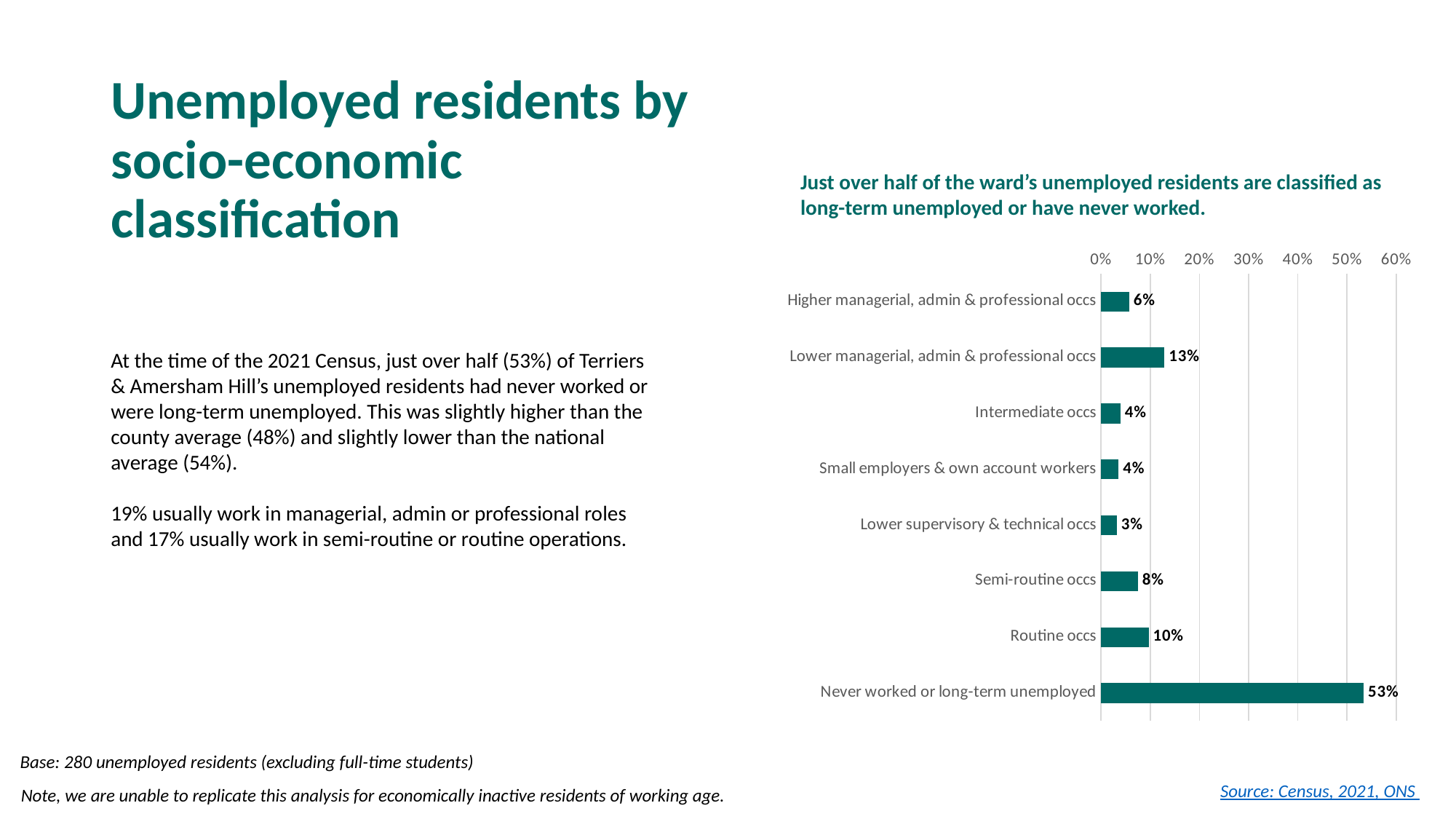
What is the value for 'Lower supervisory & technical occs'? 3% What is the source cited for the chart? Census, 2021, ONS Which category has the highest value? Never worked or long-term unemployed What is the value for 'Lower managerial, admin & professional occs'? 13% What kind of chart is shown on the slide? Bar chart What is the difference between 'Lower managerial, admin & professional occs' and 'Higher managerial, admin & professional occs'? 7% Which is larger: 'Routine occs' or 'Semi-routine occs'? Routine occs What percentage of unemployed residents are classified as 'Never worked or long-term unemployed'? 53% How many categories are shown in the chart? 8 What is the value for 'Routine occs'? 10% Is the value for 'Never worked or long-term unemployed' greater or less than 50%? greater Which category has the lowest value? Lower supervisory & technical occs